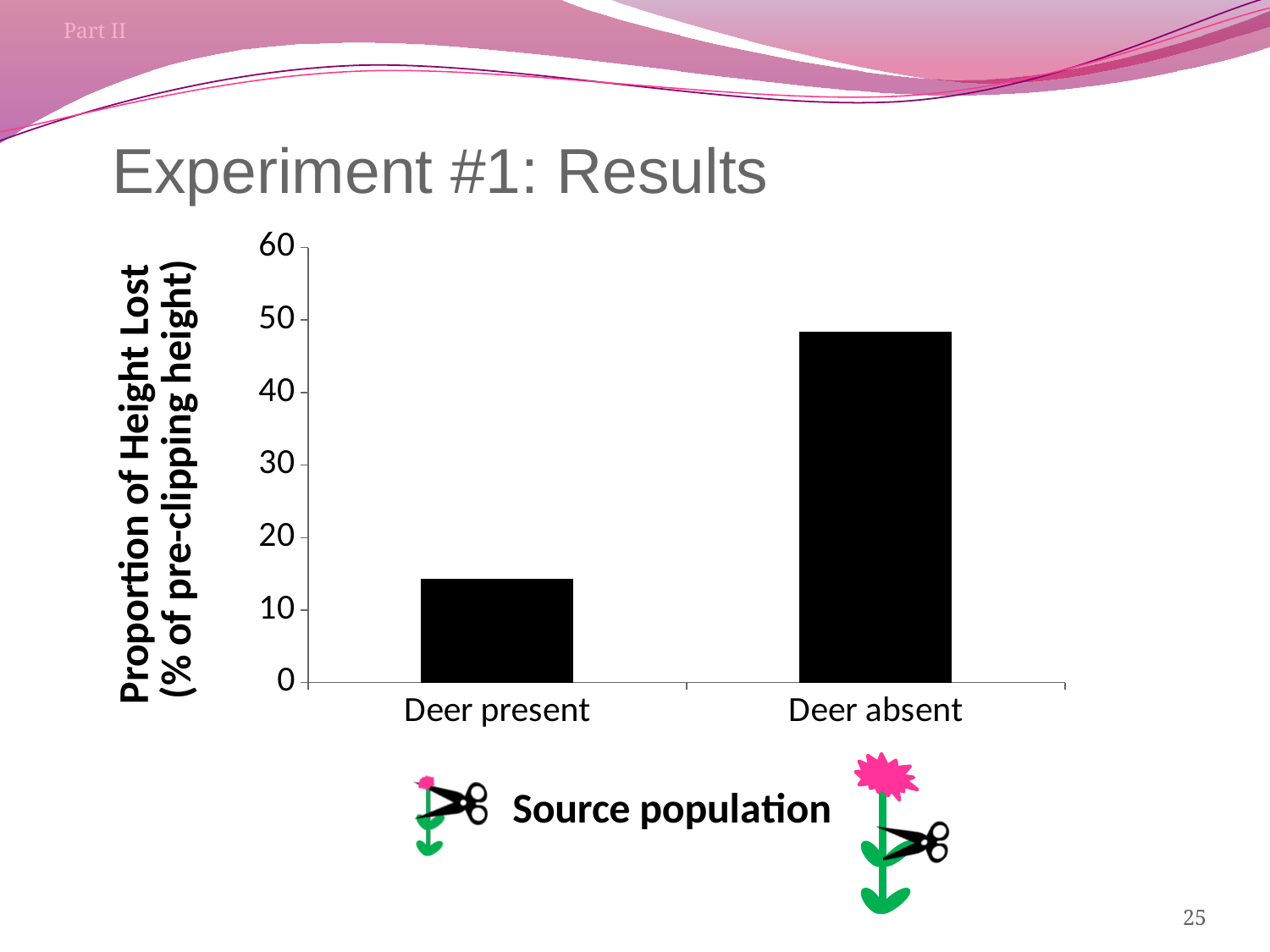
Which category has the lowest proportion of height lost? Deer present Is the value for Deer present greater or less than 20? less Is the value for Deer present greater or less than 10? greater What is the label of the x axis of the chart? Source population Do the bar values rise or fall from Deer present to Deer absent? rise What is the label of the y axis of the chart? Proportion of Height Lost (% of pre-clipping height) Which category has the highest proportion of height lost? Deer absent Is the value for Deer absent greater or less than 50? less What kind of chart is shown on the slide? bar chart How many categories are shown on the x axis of the chart? 2 Which is larger, the value for Deer present or the value for Deer absent? Deer absent